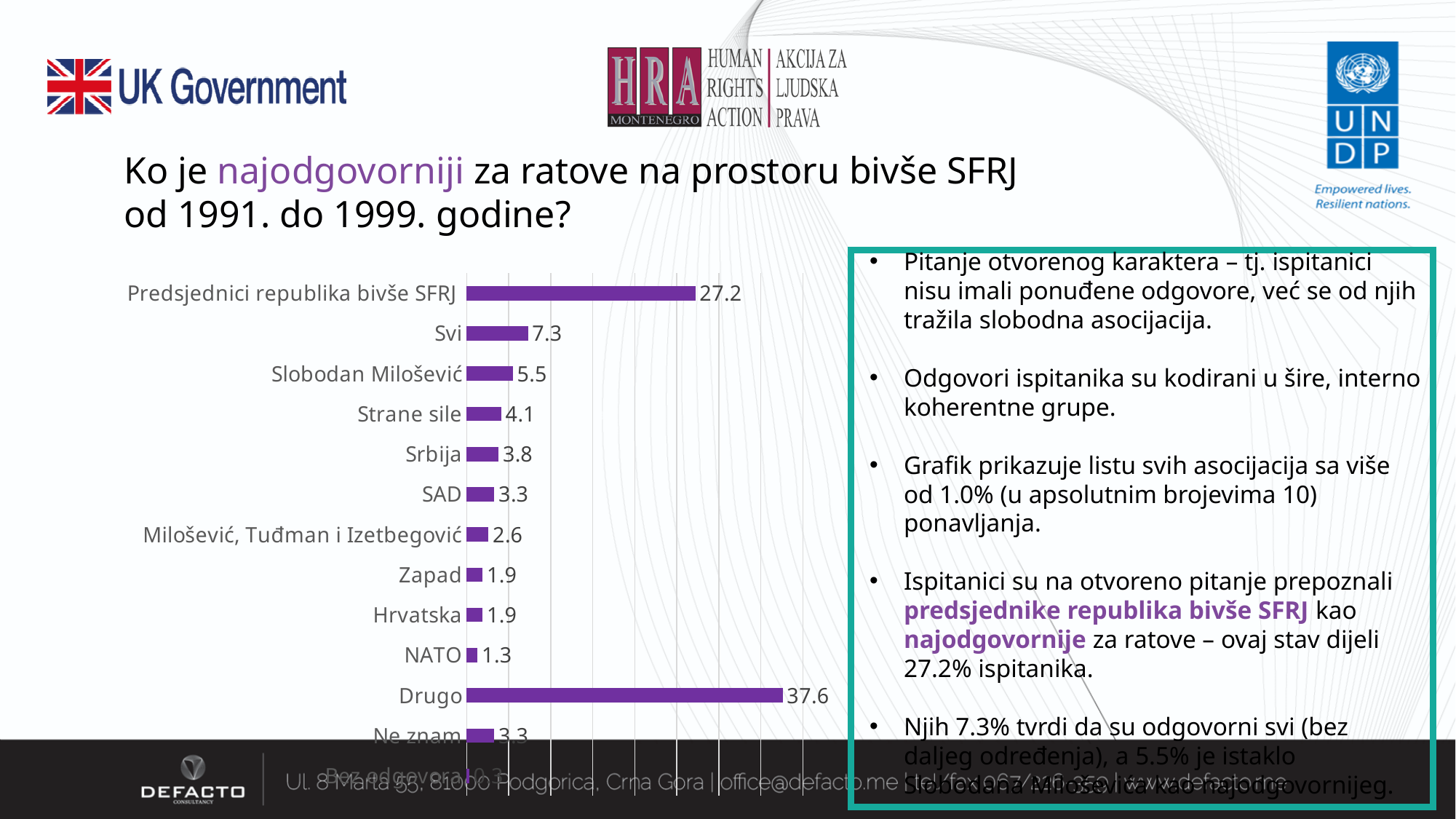
What value is shown for NATO? 1.3 What kind of chart is shown on the slide? Bar chart What is the difference between the values for Drugo and Predsjednici republika bivše SFRJ? 10.4 Which category has the highest value in the chart? Drugo What value is shown for Predsjednici republika bivše SFRJ? 27.2 What value is shown for Slobodan Milošević? 5.5 What value is shown for Svi? 7.3 What is the difference between the values for Svi and Slobodan Milošević? 1.8 What value is shown for Milošević, Tuđman i Izetbegović? 2.6 What value is shown for Drugo? 37.6 What value is shown for Strane sile? 4.1 Which has a larger value, Srbija or SAD? Srbija